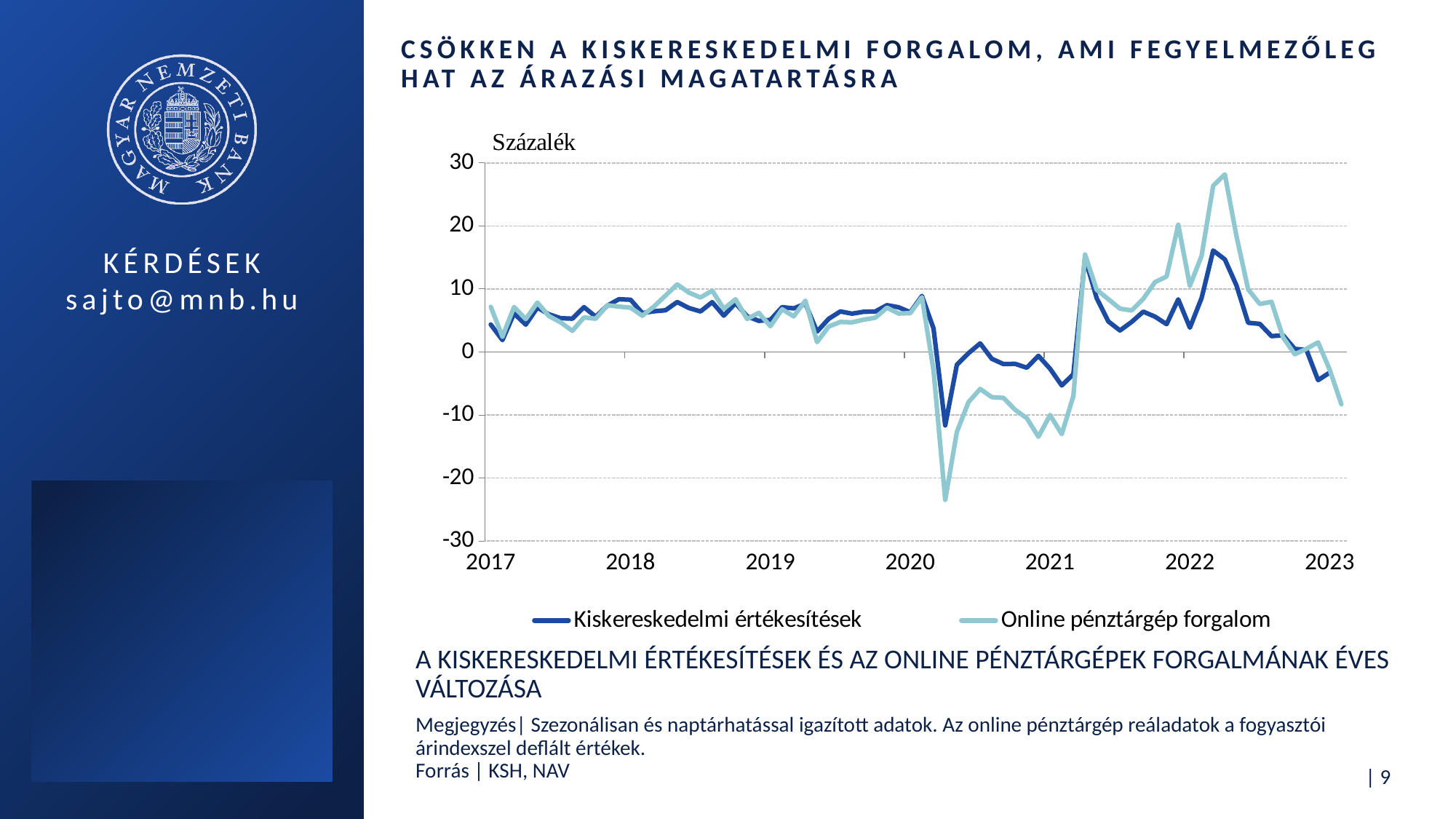
Is the peak value of Online pénztárgép forgalom in 2022 greater or less than 20? greater What type of chart is shown on the slide? line chart Is the lowest value of Online pénztárgép forgalom in 2020 greater or less than -20? less From the 2022 peak to the start of 2023, do the values of both series rise or fall? fall At the 2022 peak, which series reaches the higher value? Online pénztárgép forgalom How many year labels are shown on the horizontal axis? 7 How many series does the legend list? 2 Which series drops to the lower value in 2020? Online pénztárgép forgalom What unit label is shown above the vertical axis? Százalék What are the two series named in the legend? Kiskereskedelmi értékesítések; Online pénztárgép forgalom Is the lowest value of Kiskereskedelmi értékesítések in 2020 greater or less than -10? less